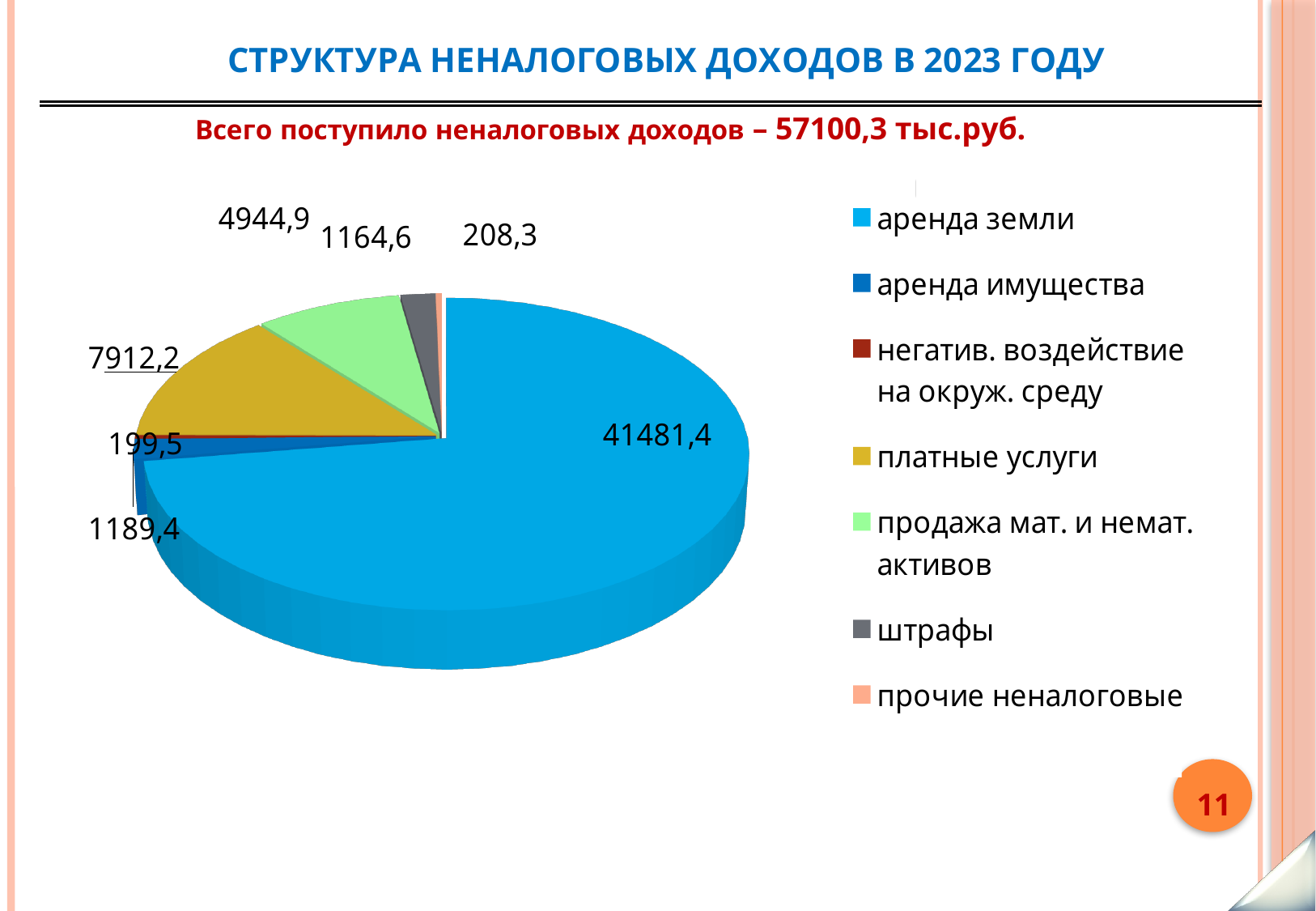
What type of chart is shown on the slide? pie chart Which category has the smallest value? негатив. воздействие на окруж. среду What is the value for штрафы? 1164,6 What is the value for негатив. воздействие на окруж. среду? 199,5 What is the difference between платные услуги and продажа мат. и немат. активов? 2967,3 What total of non-tax revenues is stated on the slide? 57100,3 тыс.руб. Which category has the largest slice of the pie? аренда земли What is the value for продажа мат. и немат. активов? 4944,9 What is the value for аренда земли? 41481,4 What is the value for платные услуги? 7912,2 How many categories does the legend list? 7 Which is larger, аренда имущества or штрафы? аренда имущества